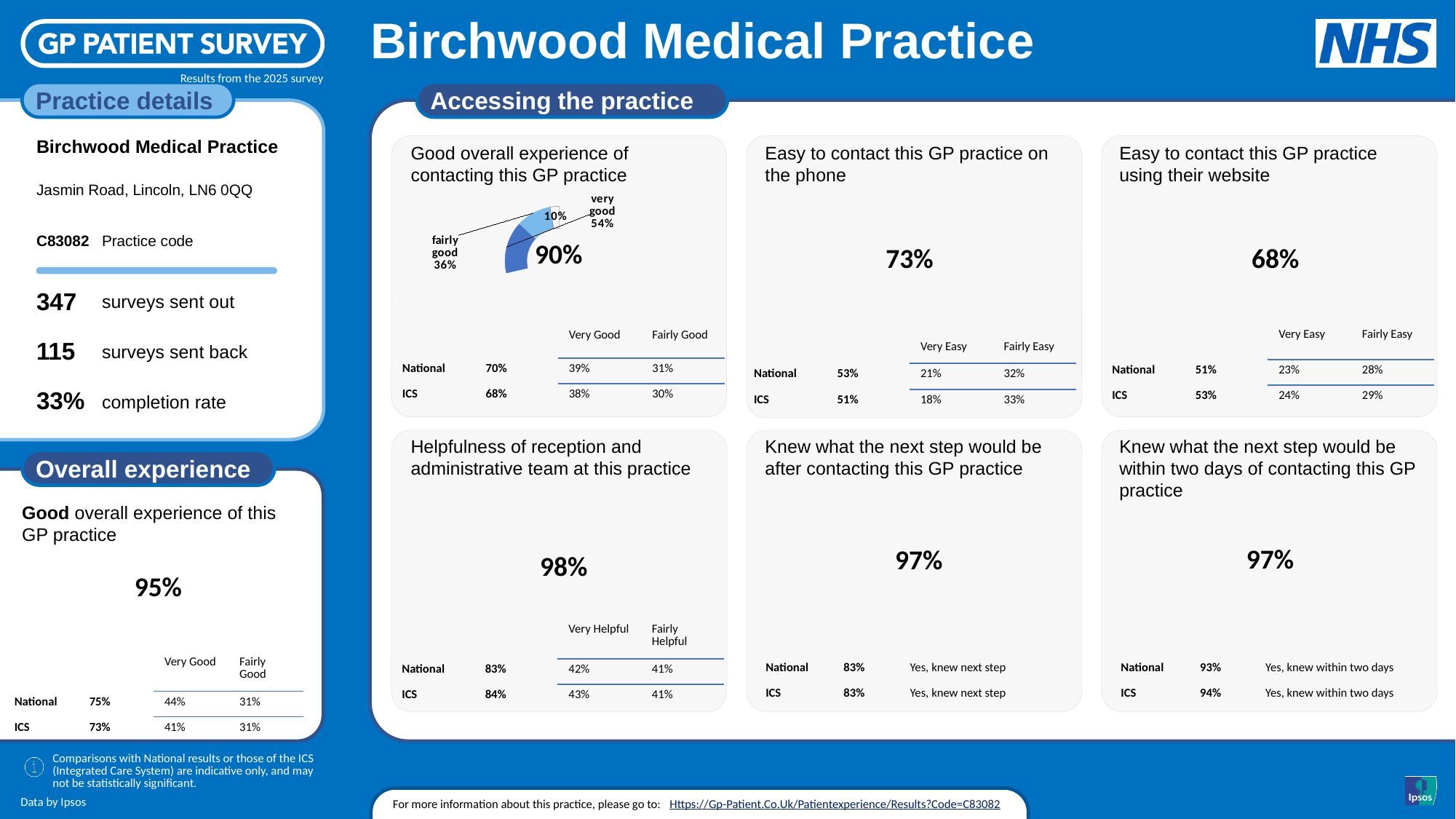
In the pie chart under 'Good overall experience of contacting this GP practice', which is larger, 'very good' or 'fairly good'? very good What is the title of the panel containing the pie chart on the slide? Good overall experience of contacting this GP practice In the pie chart under 'Good overall experience of contacting this GP practice', which labelled slice is the largest? very good In the pie chart under 'Good overall experience of contacting this GP practice', what is the combined total of the 'very good' and 'fairly good' slices? 90% How many slices does the pie chart under 'Good overall experience of contacting this GP practice' have? 3 What type of chart is shown under 'Good overall experience of contacting this GP practice'? pie chart What large percentage is printed in the centre of the pie chart under 'Good overall experience of contacting this GP practice'? 90% In the pie chart under 'Good overall experience of contacting this GP practice', what percentage is shown for 'fairly good'? 36% In the pie chart under 'Good overall experience of contacting this GP practice', what is the value of the smallest slice? 10% In the pie chart under 'Good overall experience of contacting this GP practice', what percentage is shown for 'very good'? 54% In the pie chart under 'Good overall experience of contacting this GP practice', what is the difference between the 'very good' and 'fairly good' percentages? 18%